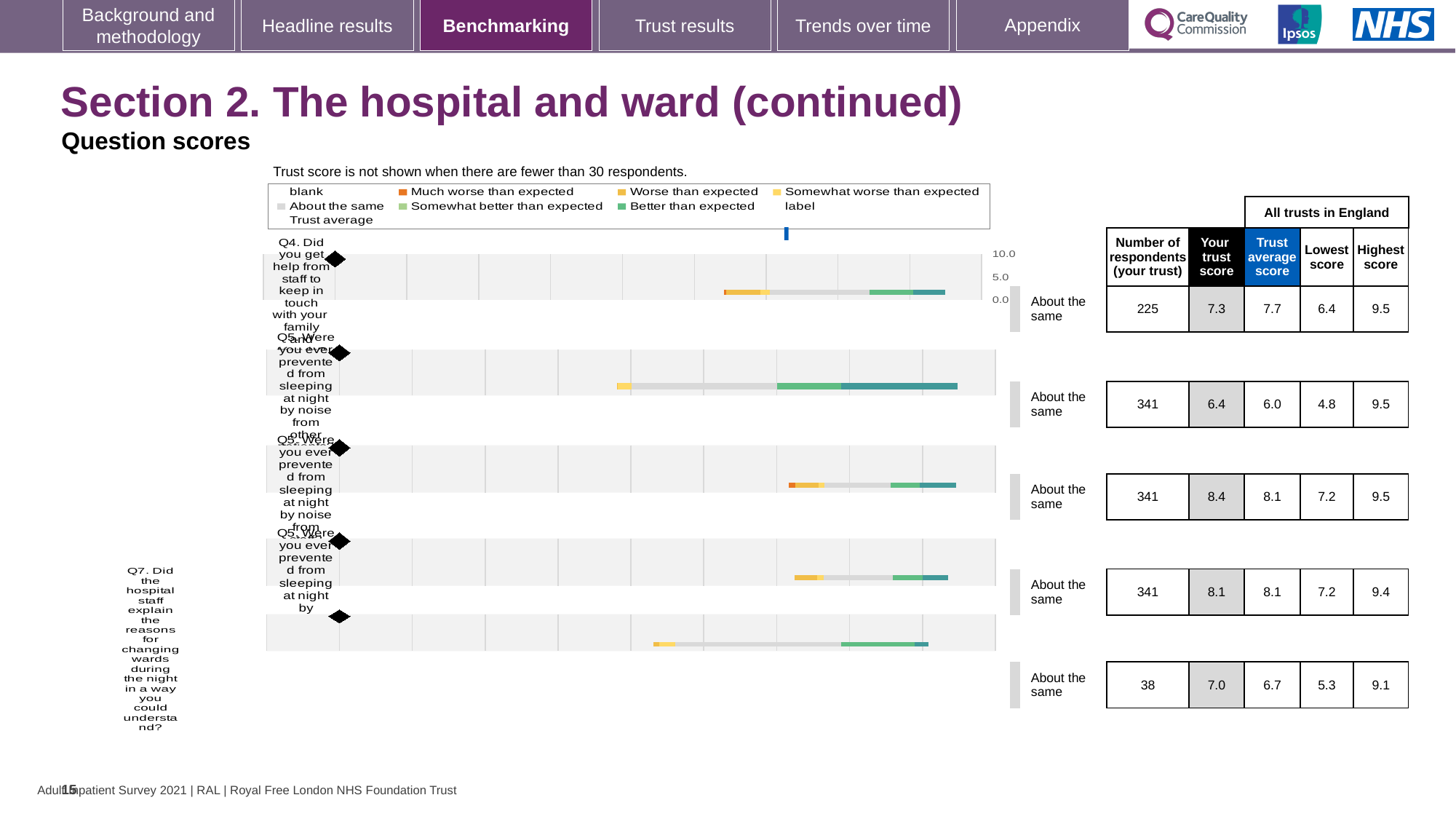
Which question has the fewest respondents in the table? Q7 What is your trust score for Q4 (help from staff to keep in touch with family)? 7.3 What is the trust average score for Q4? 7.7 For Q4, which is larger: your trust score or the trust average score? Trust average score What is your trust score for Q7? 7.0 For Q7, what is the difference between the highest score and the lowest score? 3.8 What is the number of respondents (your trust) for Q7 (explaining reasons for changing wards during the night)? 38 What kind of chart is used to show the question scores on this slide? bar chart What is the number of respondents (your trust) for Q4 in the question scores table? 225 What is the lowest score across all trusts in England for Q7? 5.3 How many question rows are plotted in the question scores chart? 5 What is the highest score across all trusts in England for Q4? 9.5